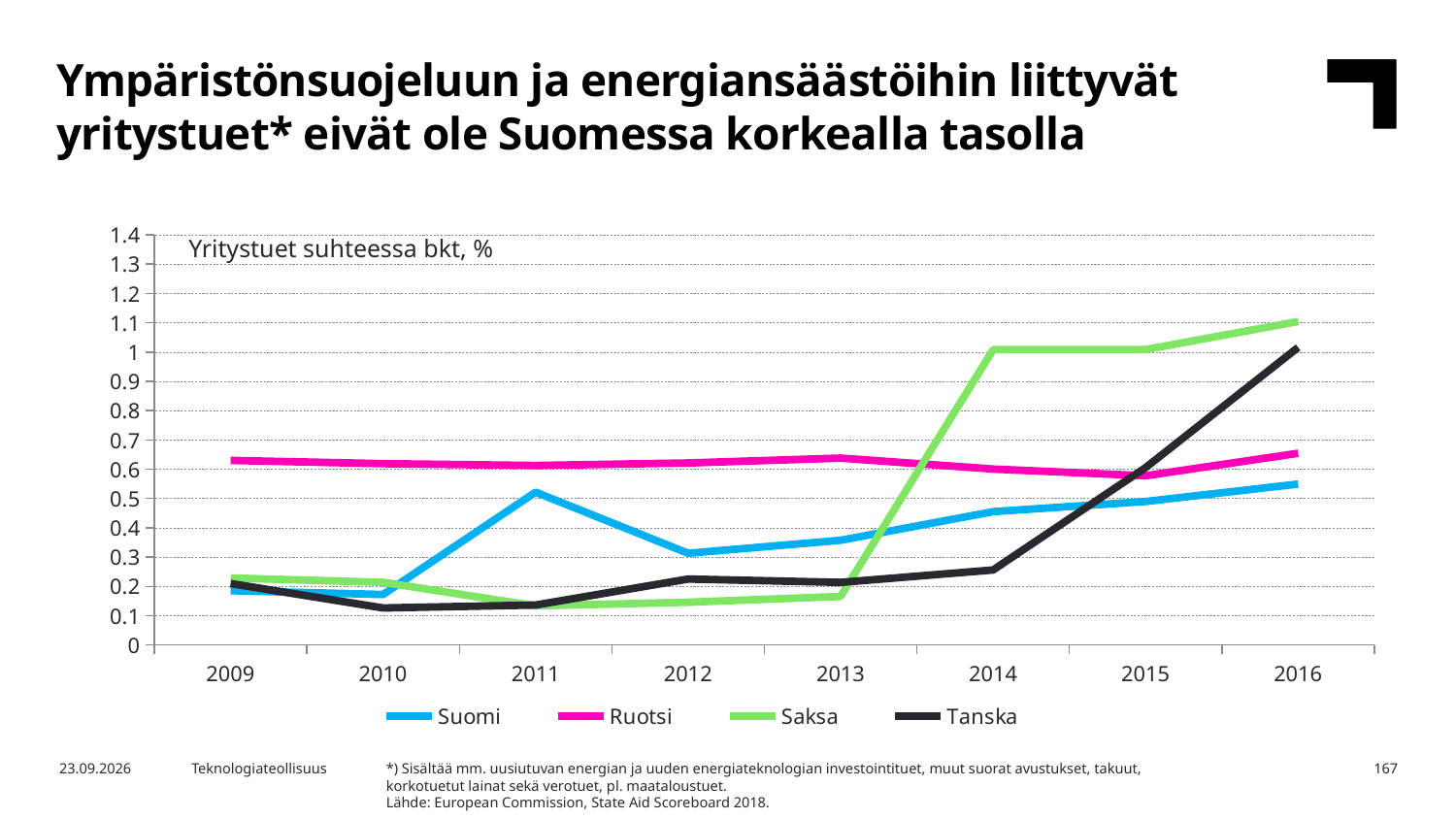
Which country has the lowest value in 2016? Suomi How many years are shown on the x axis? 8 What kind of chart is shown on the slide? line chart Which country has the highest value in 2016? Saksa In 2013, which is larger: the value for Ruotsi or the value for Suomi? Ruotsi Is the value for Saksa in 2016 greater or less than 1? greater Is the value for Suomi in 2011 greater or less than 0.4? greater Which country has the highest value in 2009? Ruotsi Does the value for Saksa rise or fall from 2013 to 2016? rise What text is shown inside the chart area as its label? Yritystuet suhteessa bkt, % How many series does the legend list? 4 Is the value for Tanska in 2010 greater or less than 0.2? less